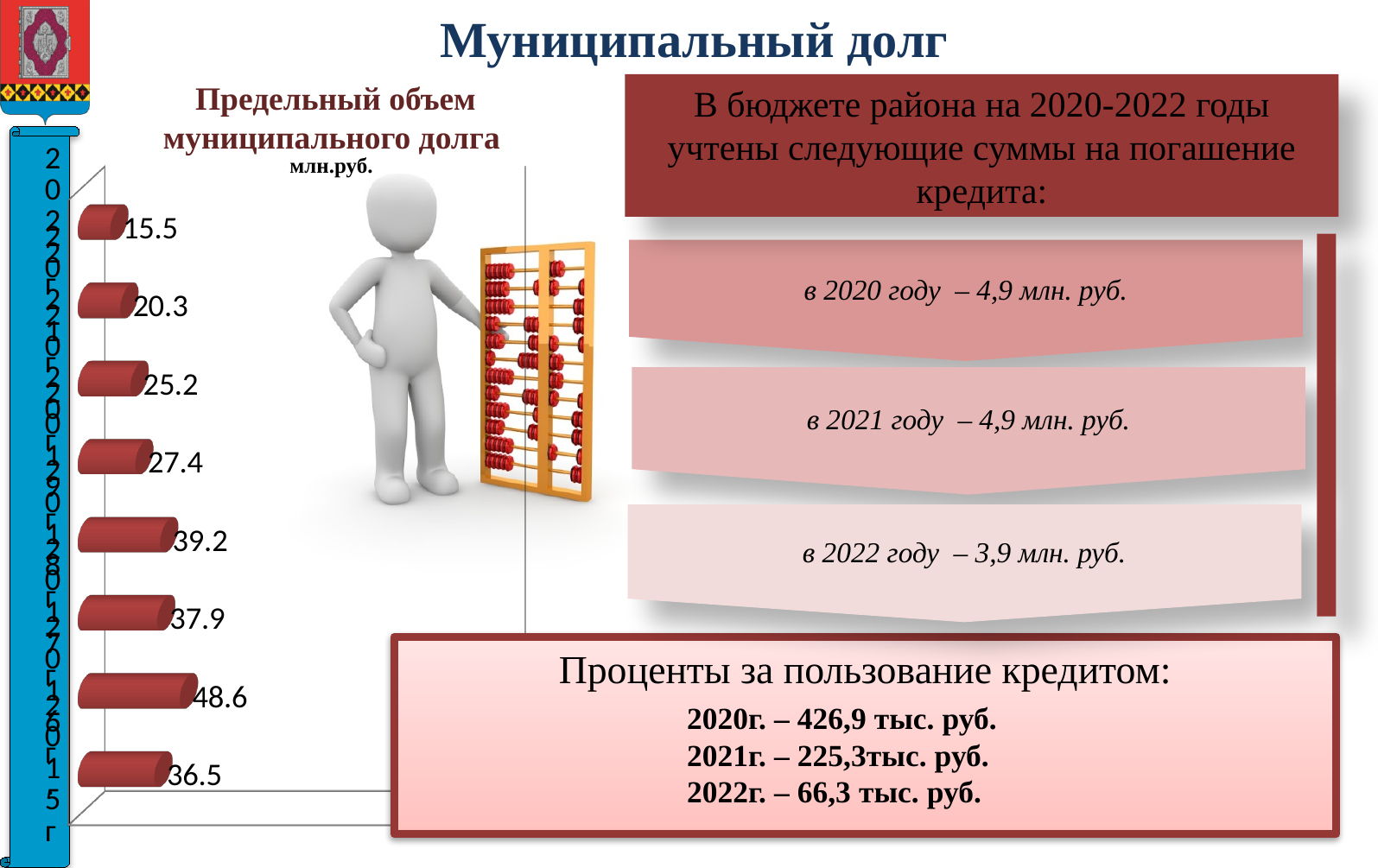
What is the lowest value shown on the "Предельный объем муниципального долга" chart? 15.5 In what unit are the values of the "Предельный объем муниципального долга" chart given? млн.руб. What is the value of the topmost bar in the "Предельный объем муниципального долга" chart? 15.5 What is the difference between the bottom bar (36.5) and the topmost bar (15.5) in the "Предельный объем муниципального долга" chart? 21.0 What is the difference between the highest bar (48.6) and the lowest bar (15.5) in the "Предельный объем муниципального долга" chart? 33.1 What kind of chart is shown on the left of the slide under the title "Предельный объем муниципального долга"? bar chart What is the highest value shown on the "Предельный объем муниципального долга" chart? 48.6 What is the value of the bottom bar in the "Предельный объем муниципального долга" chart? 36.5 What colour are the bars in the "Предельный объем муниципального долга" chart? dark red In the "Предельный объем муниципального долга" chart, which is larger: the bar labelled 39.2 or the bar labelled 37.9? 39.2 How many bars does the "Предельный объем муниципального долга" chart contain? 8 What is the value of the second bar from the top in the "Предельный объем муниципального долга" chart? 20.3